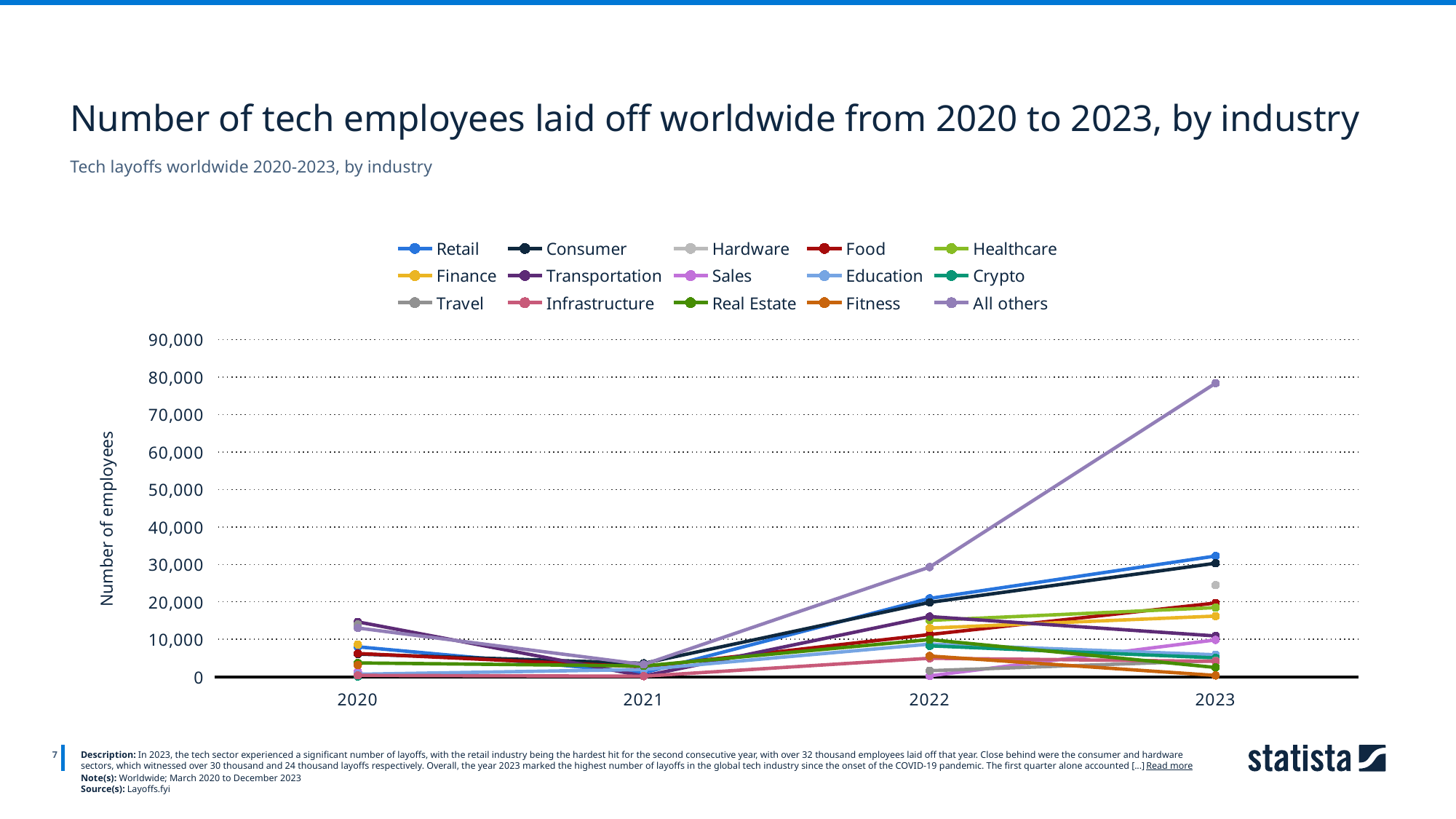
What kind of chart is shown on the slide? line chart How many series does the legend list? 15 Is the value for Hardware in 2023 greater or less than 20,000? greater What is the title of the chart? Number of tech employees laid off worldwide from 2020 to 2023, by industry What is the label of the y axis? Number of employees Which is larger in 2023, the value for All others or the value for Retail? All others How many years are shown along the x axis? 4 Which series has the highest value in 2023? All others Is the value for All others in 2022 greater or less than 20,000? greater Does the All others series rise or fall from 2021 to 2023? rise Is the value for All others in 2023 greater or less than 70,000? greater